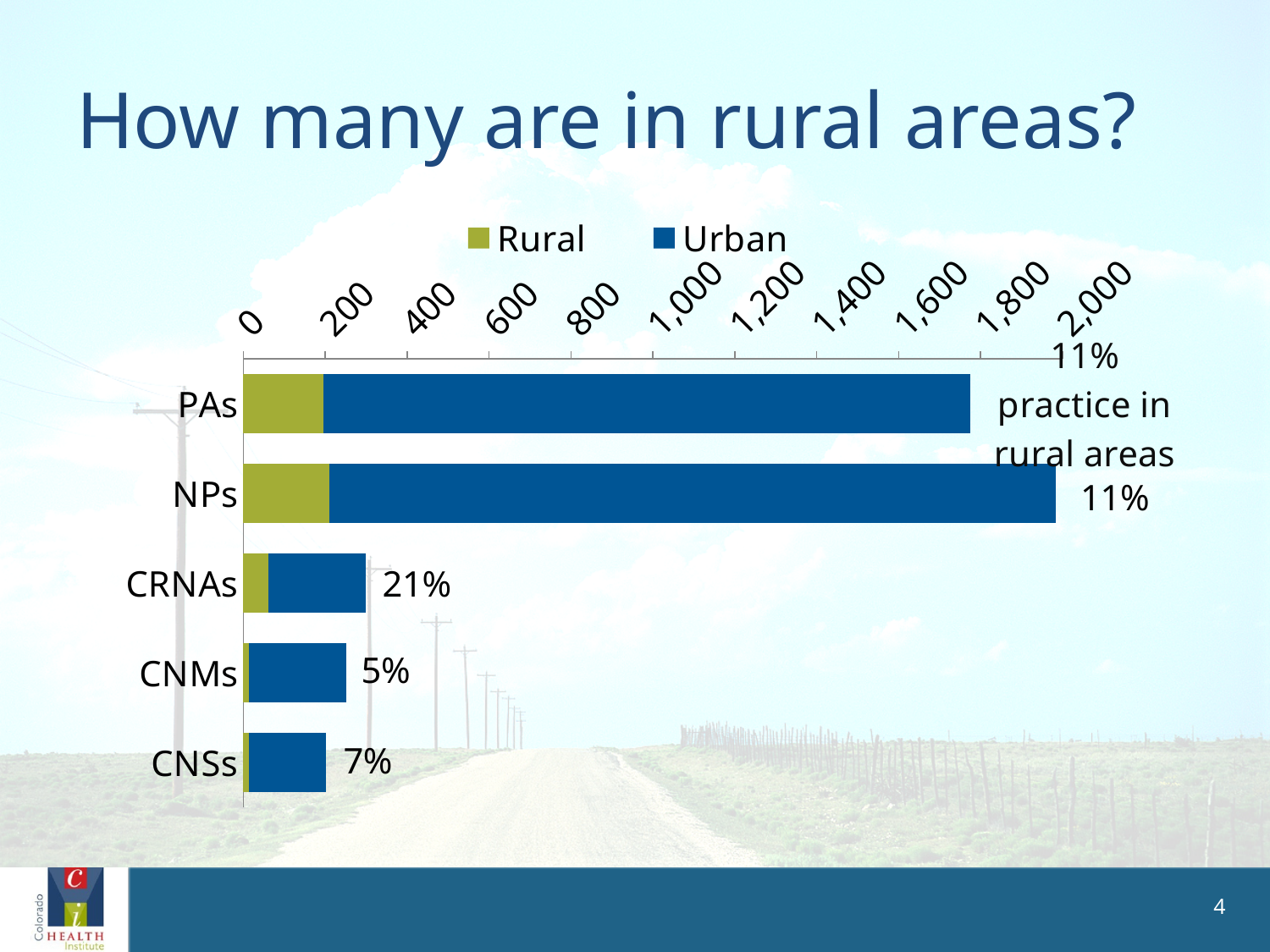
How many series does the legend list? 2 What percentage label is shown next to the CNMs bar? 5% What percentage label is shown next to the NPs bar? 11% What kind of chart is shown on the slide? bar chart What percentage label is shown next to the CNSs bar? 7% Which has the longer total bar, CRNAs or CNMs? CRNAs Which series is shown in blue in the legend? Urban Is the total bar length for PAs greater or less than 1,600? greater What percentage label is shown next to the CRNAs bar? 21% How many provider categories are plotted on the chart? 5 Is the total bar length for CRNAs greater or less than 400? less Which category has the longest total bar? NPs